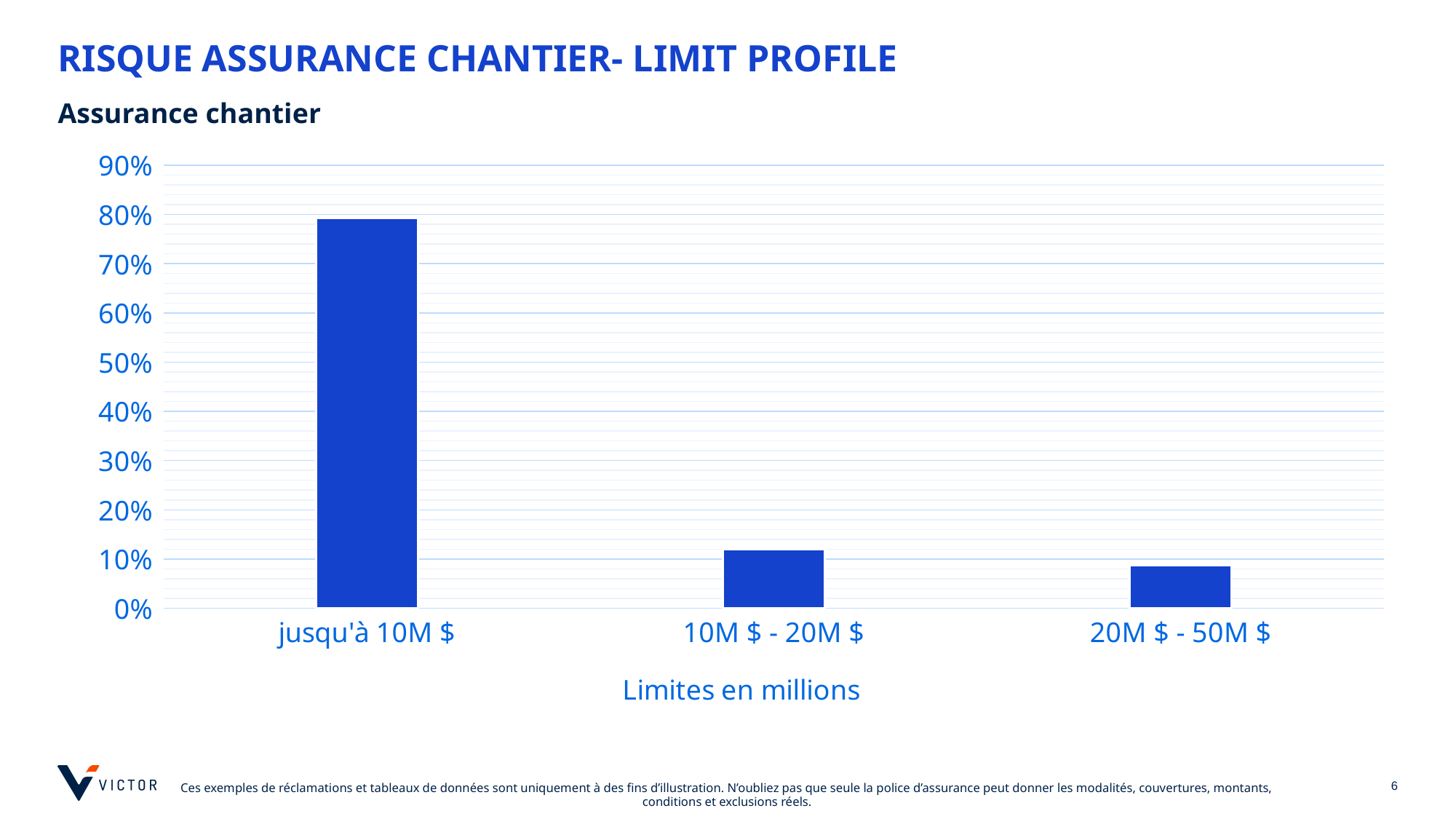
What kind of chart is shown on the slide? bar chart Which category has the highest value in the chart? jusqu'à 10M $ Is the value for "10M $ - 20M $" greater or less than 20%? less Which is larger, the value for "10M $ - 20M $" or the value for "20M $ - 50M $"? 10M $ - 20M $ Is the value for "jusqu'à 10M $" greater or less than 70%? greater What is the title of the chart? Assurance chantier What is the x axis title of the chart? Limites en millions How many categories are shown on the x axis of the chart? 3 Do the values rise or fall from left to right along the x axis? fall Is the value for "jusqu'à 10M $" greater or less than 50%? greater Which category has the lowest value in the chart? 20M $ - 50M $